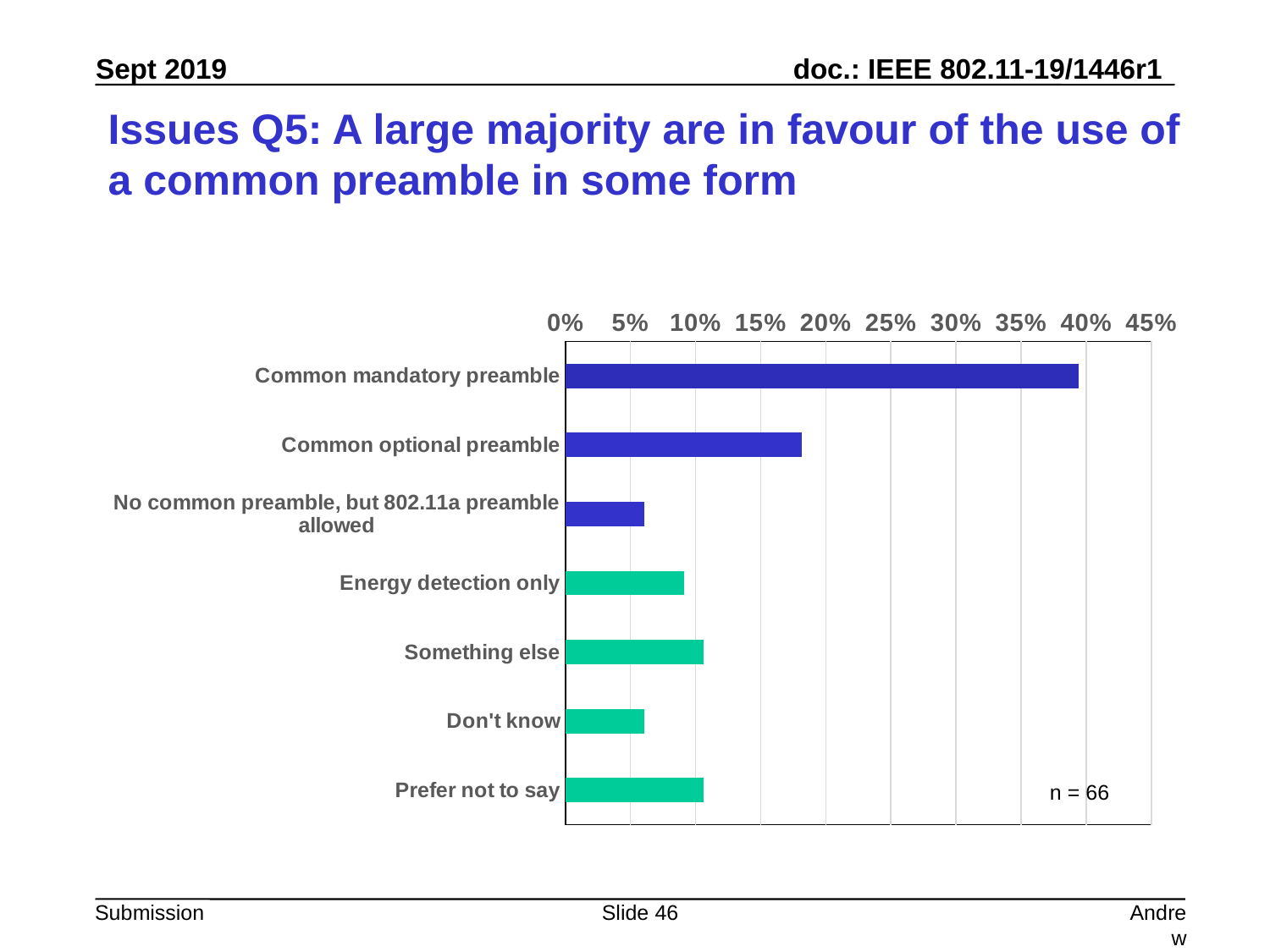
How many categories are plotted in the chart? 7 Is the value for Prefer not to say greater or less than 5%? greater Which is larger, the value for Common optional preamble or the value for Something else? Common optional preamble Is the value for Common mandatory preamble greater or less than 35%? greater Is the value for No common preamble, but 802.11a preamble allowed greater or less than 10%? less Which is larger, the value for Common mandatory preamble or the value for Common optional preamble? Common mandatory preamble Which category has the highest value in the chart? Common mandatory preamble What kind of chart is shown on the slide? bar chart What sample size is noted on the chart? n = 66